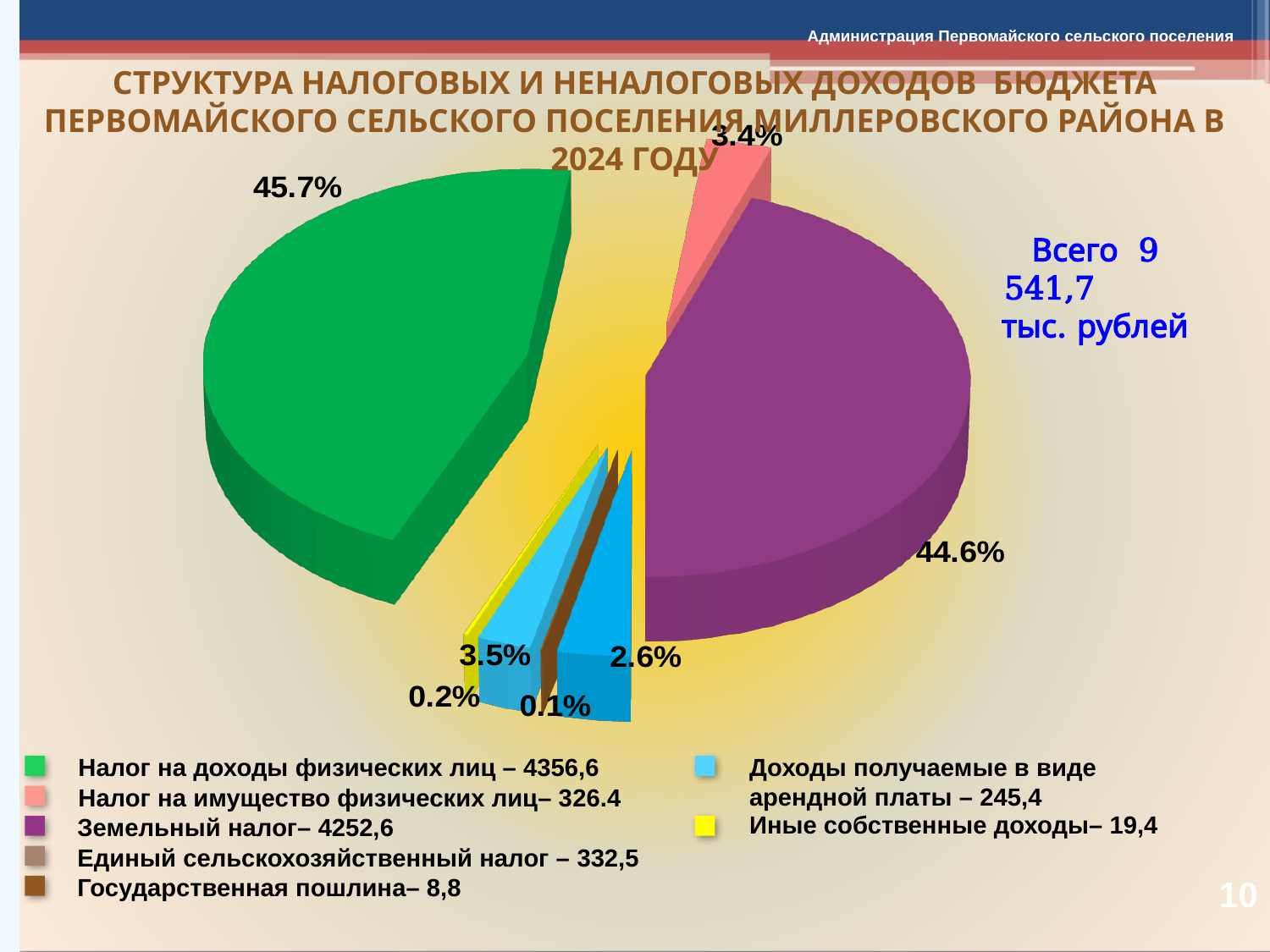
What share of the pie does Налог на имущество физических лиц have? 3.4% What share of the pie does Земельный налог have? 44.6% Which category has the largest share of the pie? Налог на доходы физических лиц What value is given in the legend for Государственная пошлина? 8,8 What share of the pie does Налог на доходы физических лиц have? 45.7% What kind of chart is shown on the slide? Pie chart What value is given in the legend for Земельный налог? 4252,6 How many categories does the legend list? 7 Which is larger: the share of Налог на доходы физических лиц or the share of Земельный налог? Налог на доходы физических лиц What value is given in the legend for Доходы получаемые в виде арендной платы? 245,4 What total amount is stated on the slide for the budget revenues? 9 541,7 тыс. рублей What is the smallest percentage labelled on the pie? 0.1%